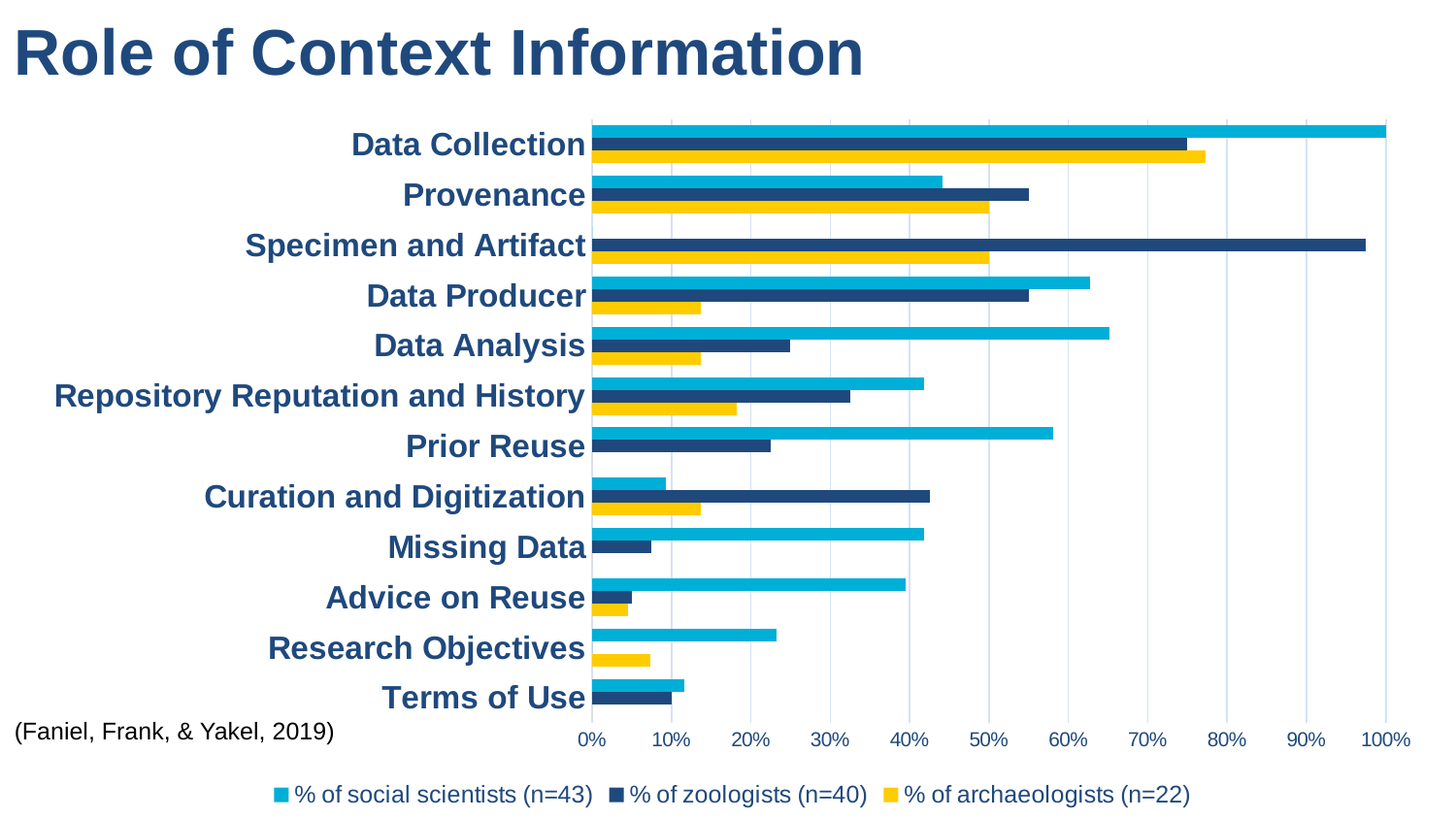
How many series does the legend list? 3 Is the value for % of archaeologists for Data Producer greater or less than 20%? less What is the title of the chart? Role of Context Information Which category has the highest value for % of zoologists? Specimen and Artifact How many categories are plotted on the y axis? 12 Is the value for % of social scientists for Missing Data greater or less than 30%? greater What is the value for % of social scientists for Data Collection? 100% Which category has the highest value for % of social scientists? Data Collection For Provenance, which is larger: % of social scientists or % of zoologists? % of zoologists Is the value for % of zoologists for Specimen and Artifact greater or less than 90%? greater For Prior Reuse, which is larger: % of social scientists or % of zoologists? % of social scientists What kind of chart is shown on the slide? bar chart